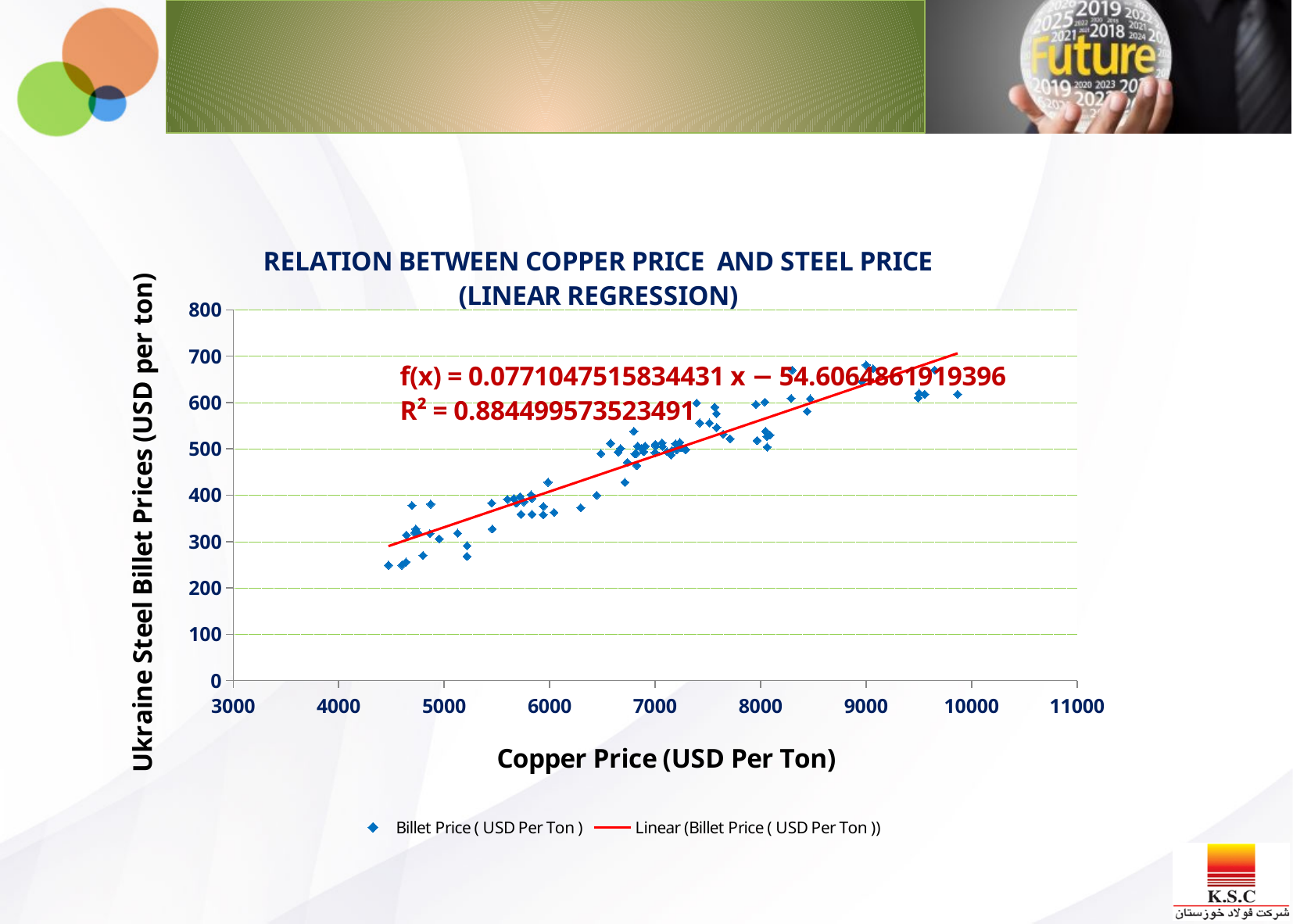
What is the highest value shown on the y axis? 800 What is the R² value shown on the chart? 0.884499573523491 What is the slope of the regression line f(x) shown on the chart? 0.0771047515834431 What is the intercept of the regression line f(x) shown on the chart? −54.6064861919396 Do the billet prices rise or fall as the copper price increases along the x axis? rise Are the billet prices for copper prices around 4500 greater or less than 300? less How many entries does the chart legend list? 2 What kind of chart is shown on the slide? scatter chart Are the billet prices for copper prices around 6000 greater or less than 500? less What is the title of the chart? RELATION BETWEEN COPPER PRICE AND STEEL PRICE (LINEAR REGRESSION) Are the billet prices for copper prices around 9000 greater or less than 600? greater What is the label of the x axis? Copper Price (USD Per Ton)